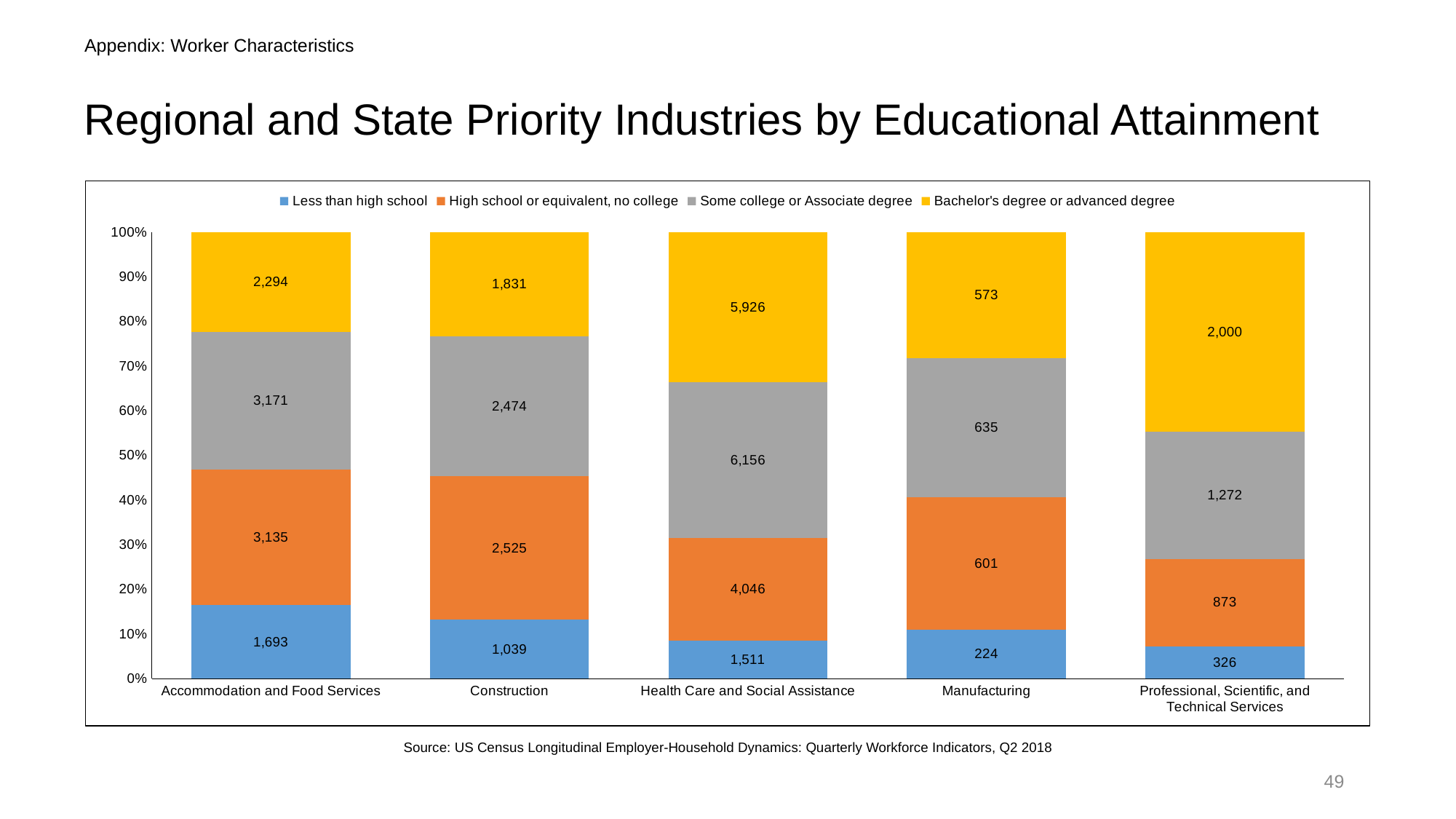
Which industry has the lowest value for Less than high school? Manufacturing What is the value for Some college or Associate degree in Construction? 2,474 What kind of chart is shown on the slide? Stacked bar chart What is the difference between the Some college or Associate degree values for Accommodation and Food Services and Construction? 697 Which colour represents Bachelor's degree or advanced degree in the legend? Yellow How many industries are shown on the x axis? 5 Which industry has the highest value for High school or equivalent, no college? Health Care and Social Assistance Which is larger: the Bachelor's degree or advanced degree value for Accommodation and Food Services or for Construction? Accommodation and Food Services What is the value for Less than high school in Health Care and Social Assistance? 1,511 What is the value for Bachelor's degree or advanced degree in Professional, Scientific, and Technical Services? 2,000 What is the total of all four segments for Manufacturing? 2,033 How many series does the legend list? 4